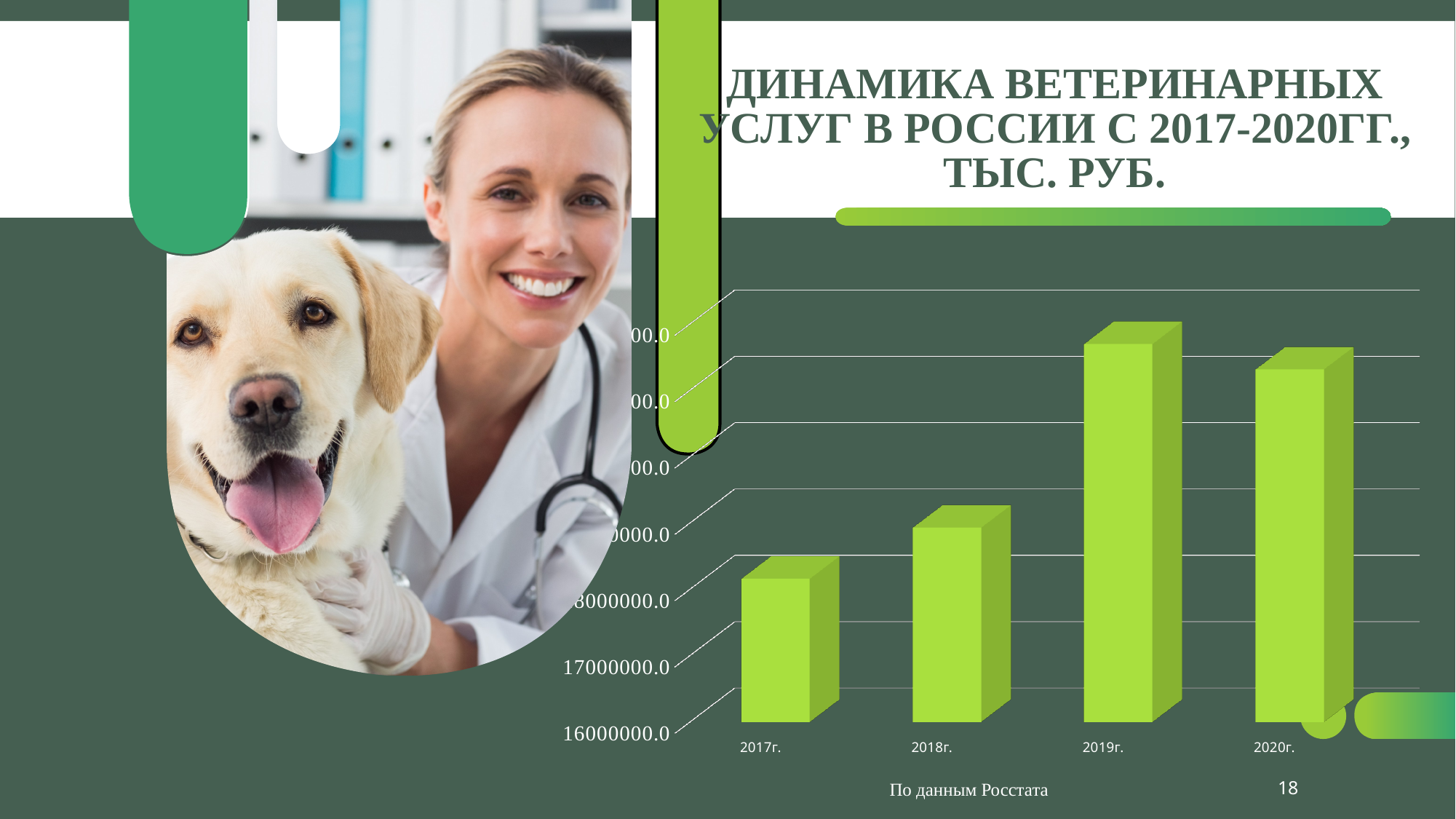
Which is larger, the value for 2018г. or the value for 2019г.? 2019г. What is the lowest value shown on the vertical axis of the chart? 16000000.0 What kind of chart is shown on the slide? bar chart Is the value for 2020г. greater or less than 20000000.0? greater Is the value for 2018г. greater or less than 20000000.0? less Which year has the lowest value on the chart? 2017г. Is the value for 2017г. greater or less than 19000000.0? less How many years (categories) are plotted on the chart? 4 Do the values rise or fall from 2017г. to 2019г.? rise